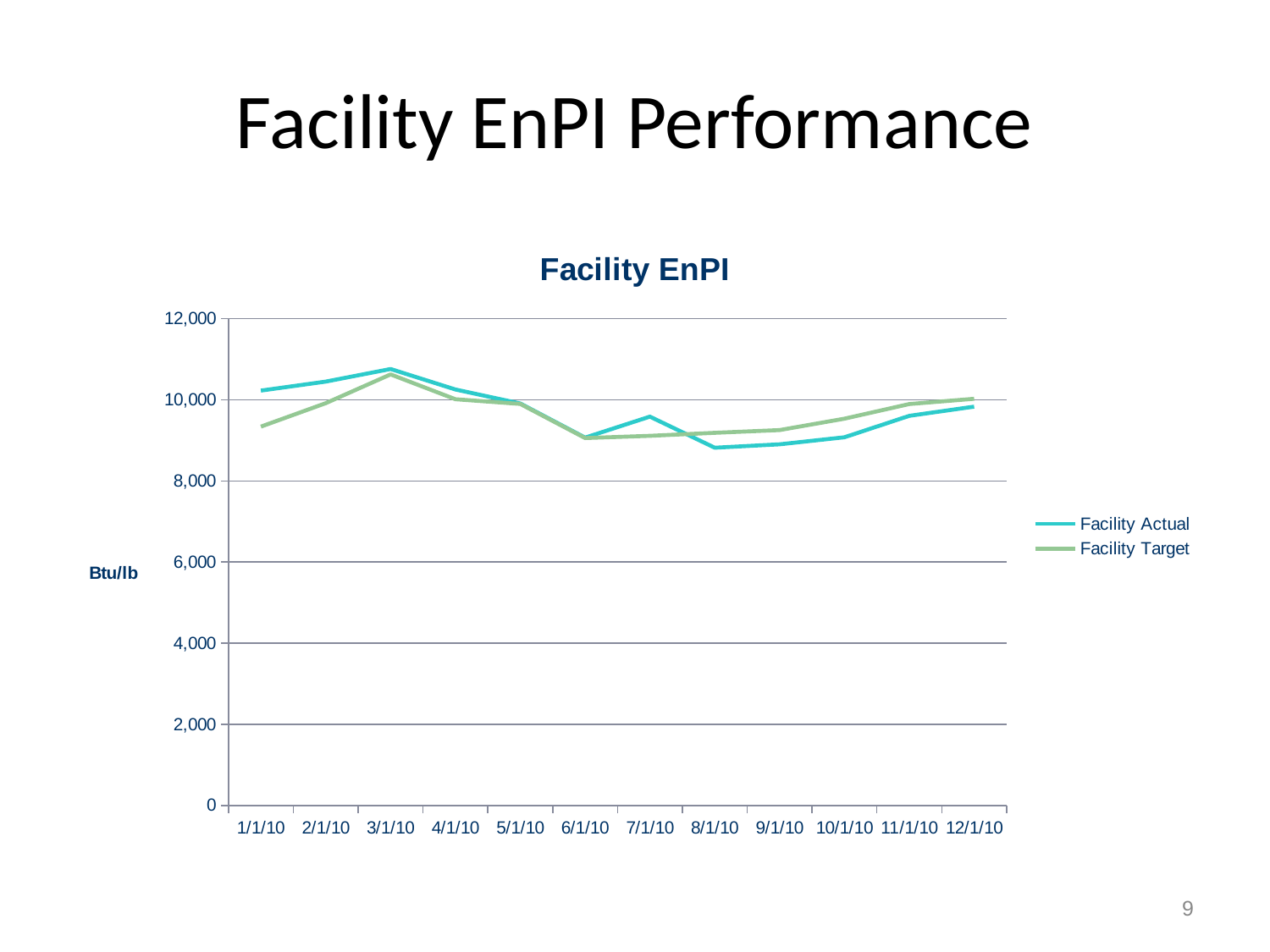
At 10/1/10, which is higher: Facility Actual or Facility Target? Facility Target What is the title of the chart? Facility EnPI At 1/1/10, which is higher: Facility Actual or Facility Target? Facility Actual Does the Facility Actual line rise or fall from 3/1/10 to 6/1/10? fall Is the Facility Actual value at 8/1/10 greater or less than 10,000? less On which date does Facility Actual reach its highest value? 3/1/10 Is the Facility Actual value at 3/1/10 greater or less than 10,000? greater What kind of chart is shown on the slide? Line chart How many dates are shown along the x axis? 12 What is the label on the vertical axis? Btu/lb How many series does the legend list? 2 Is the Facility Target value at 1/1/10 greater or less than 10,000? less